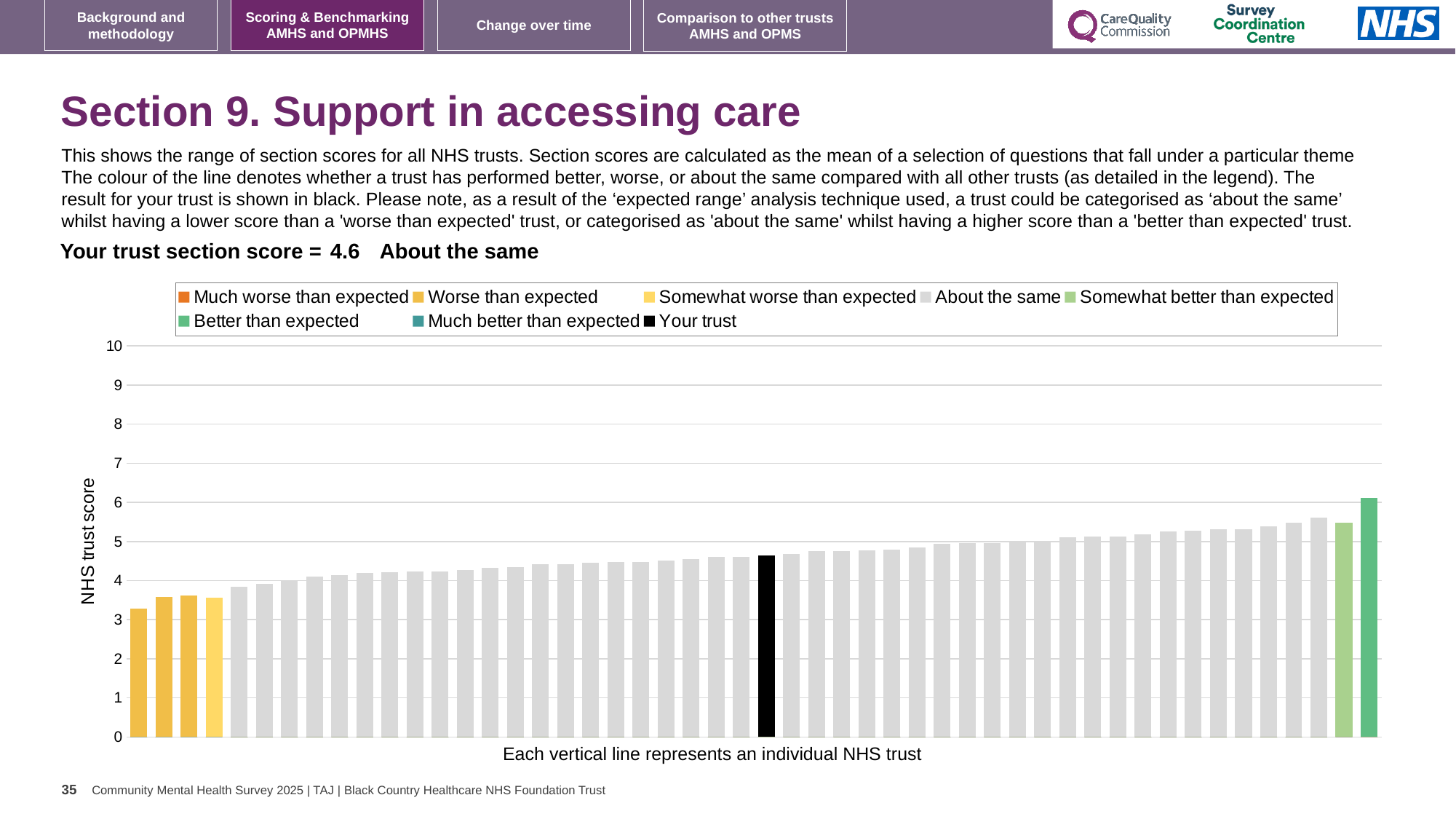
How many entries does the chart legend list? 8 Is the value of the leftmost (lowest) bar greater or less than 4? less What kind of chart is shown on the slide? bar chart Is the value of the black 'Your trust' bar greater or less than 4? greater Is the value of the leftmost (lowest) bar greater or less than 3? greater What is the section score for your trust? 4.6 Which category does your trust fall into according to the slide? About the same What colour is the bar representing your trust? black What is the label on the y axis of the chart? NHS trust score Do the bar values rise or fall from left to right along the x axis? rise